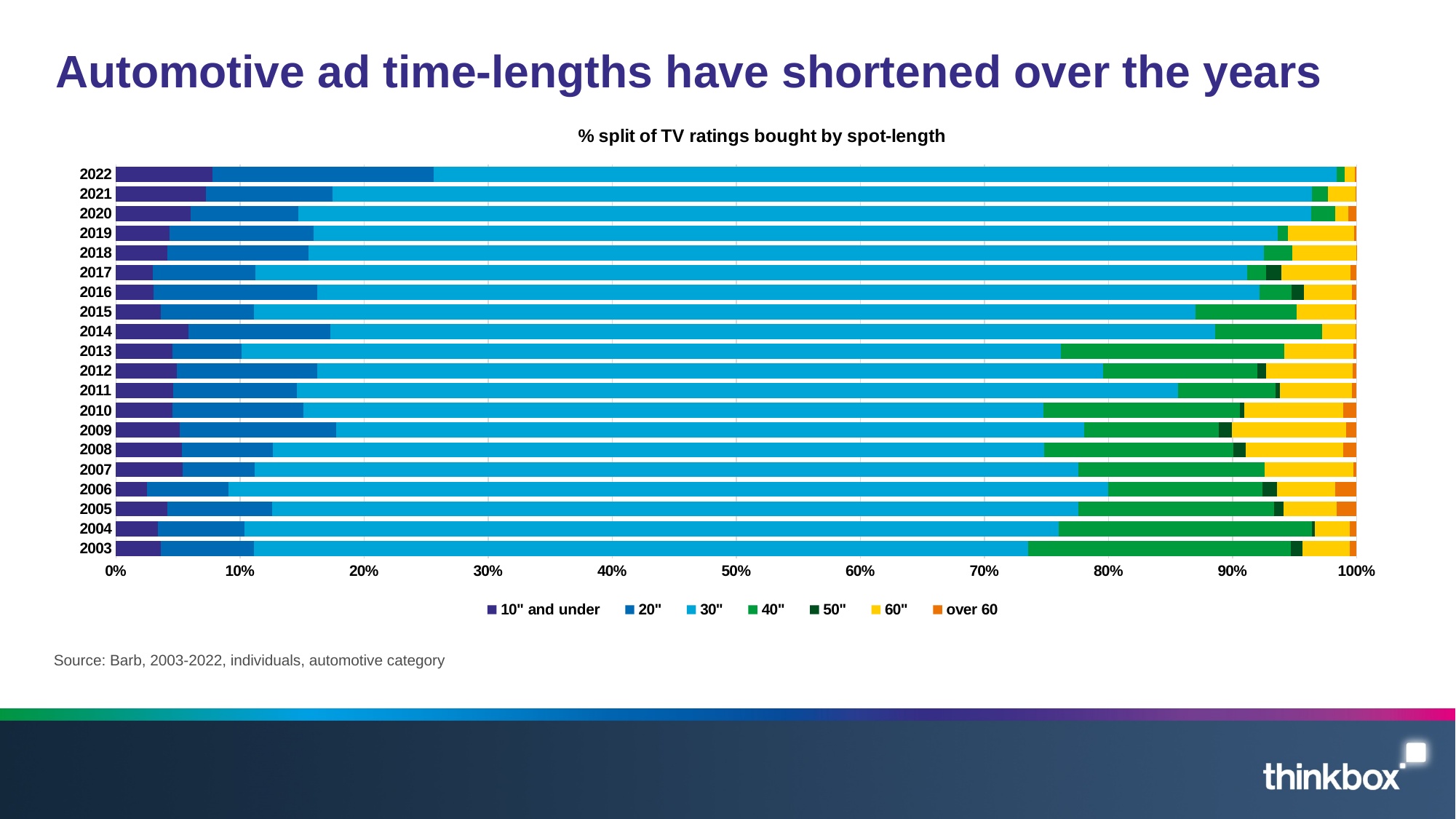
Is the value for the 40" segment in 2022 greater or less than 5%? less Which legend entry is shown in yellow? 60" Is the value for the 40" segment in 2013 greater or less than 10%? greater How many series does the legend list? 7 How many years are plotted on the chart? 20 Which is larger, the 20" segment in 2022 or the 20" segment in 2003? 2022 What is the title of the chart? % split of TV ratings bought by spot-length Is the value for the 30" segment in 2022 greater or less than 70%? greater Which year has the largest 20" segment? 2022 What kind of chart is shown on the slide? Stacked bar chart